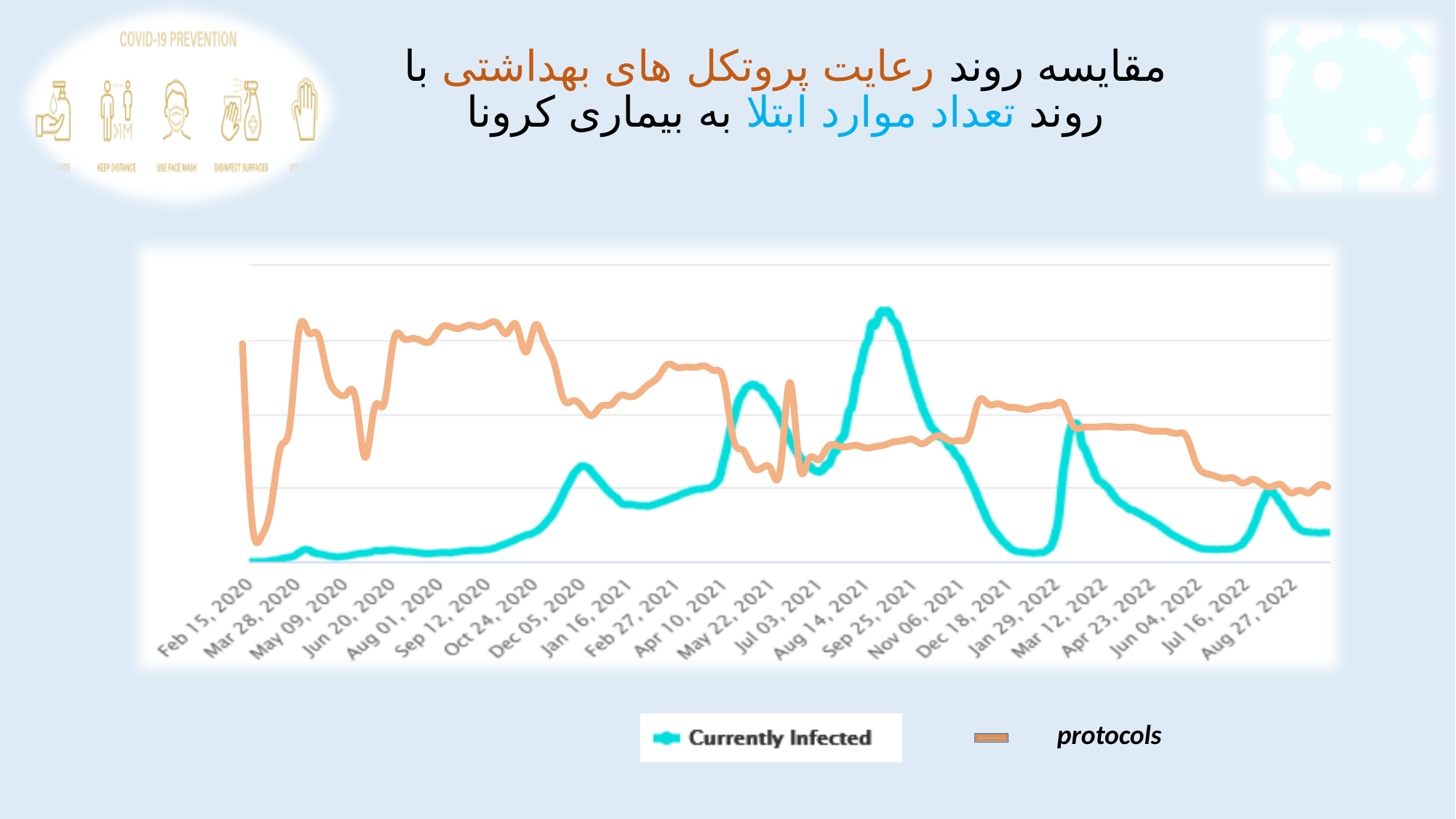
What are the two series named in the legend? Currently Infected and protocols Does the Currently Infected line rise or fall between Feb 15, 2020 and Mar 28, 2020? rise Around Sep 25, 2021, which series has the higher value, Currently Infected or protocols? Currently Infected At Feb 15, 2020, which series has the higher value, Currently Infected or protocols? protocols What is the first date label on the x axis? Feb 15, 2020 At Aug 27, 2022, which series has the higher value, Currently Infected or protocols? protocols Does the protocols line overall rise or fall from the start of the x axis to the end? fall What colour is the Currently Infected line? cyan What is the last date label on the x axis? Aug 27, 2022 What kind of chart is shown on the slide? line chart How many date labels are shown along the x axis? 23 How many series does the legend list? 2